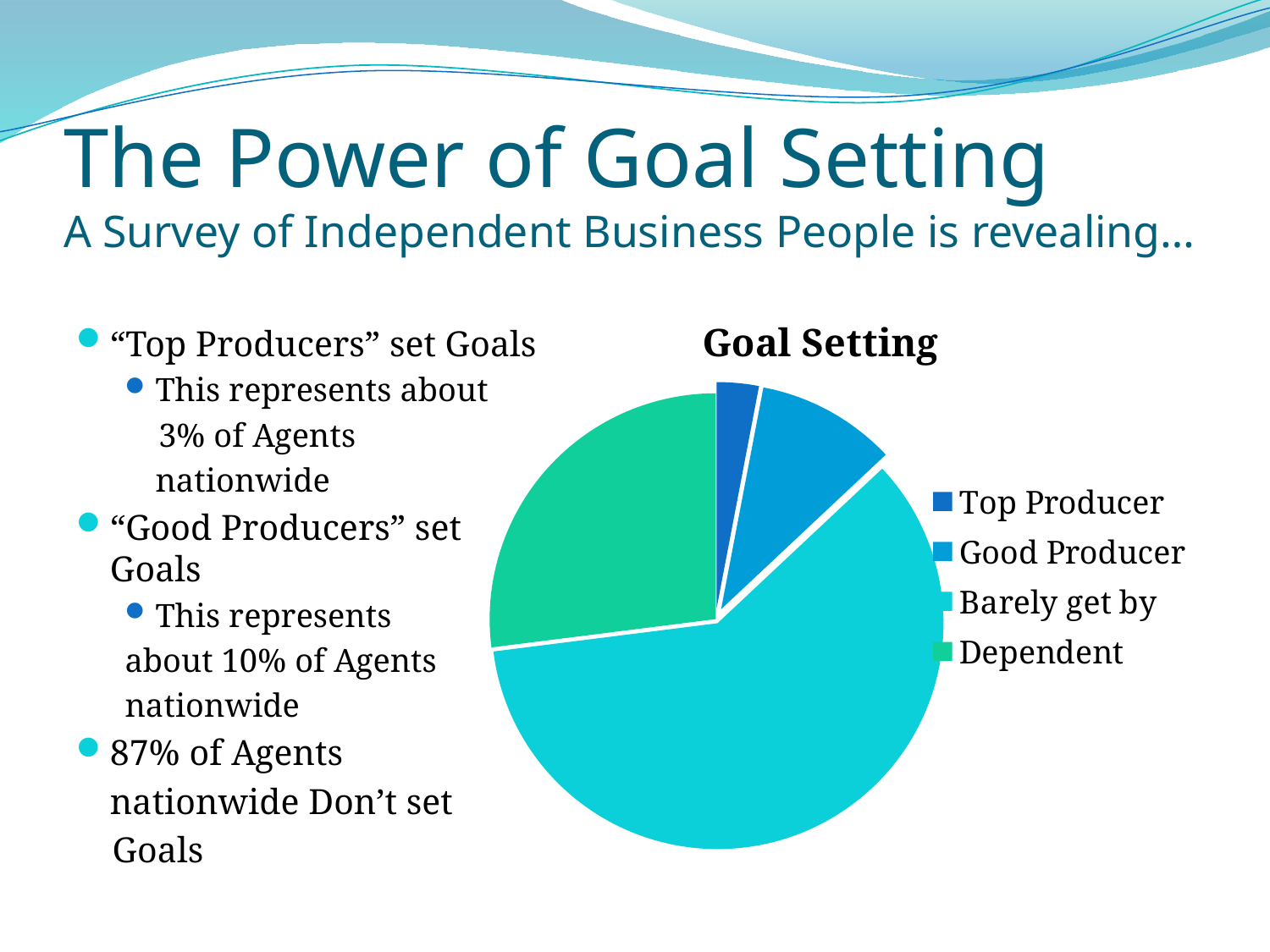
What kind of chart is shown on the slide? Pie chart What is the title of the chart? Goal Setting Which slice is larger, Barely get by or Dependent? Barely get by Which category has the second-largest slice of the pie? Dependent How many entries does the chart's legend list? 4 Which slice is larger, Good Producer or Top Producer? Good Producer How many slices does the pie chart have? 4 Which category is shown in green in the pie chart? Dependent Which slice is larger, Dependent or Good Producer? Dependent Which category has the largest slice of the pie? Barely get by Which category has the smallest slice of the pie? Top Producer